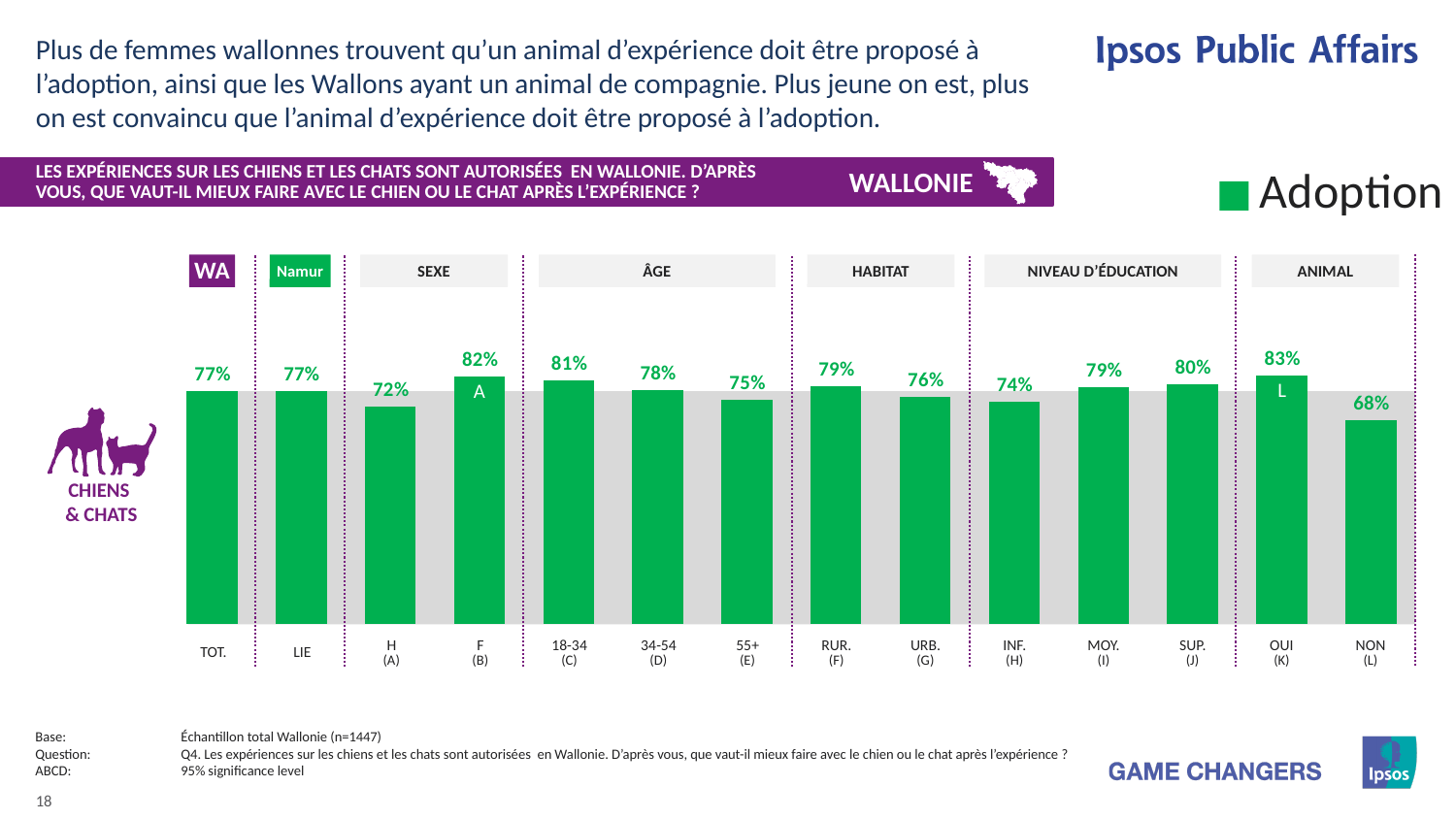
Which category has the lowest value? NON (L) Do the values rise or fall across the age groups from 18-34 to 55+? fall Which category has the highest value? OUI (K) What is the difference between the values for F and H? 10% What is the legend entry shown for the chart? Adoption What is the value for NON (no pet)? 68% Which is larger, the value for RUR. or the value for URB.? RUR. What is the value for F (women)? 82% What is the value for the 18-34 age group? 81% How many bars are plotted in the chart? 14 What kind of chart is shown? bar chart What is the value for TOT. (total Wallonia)? 77%